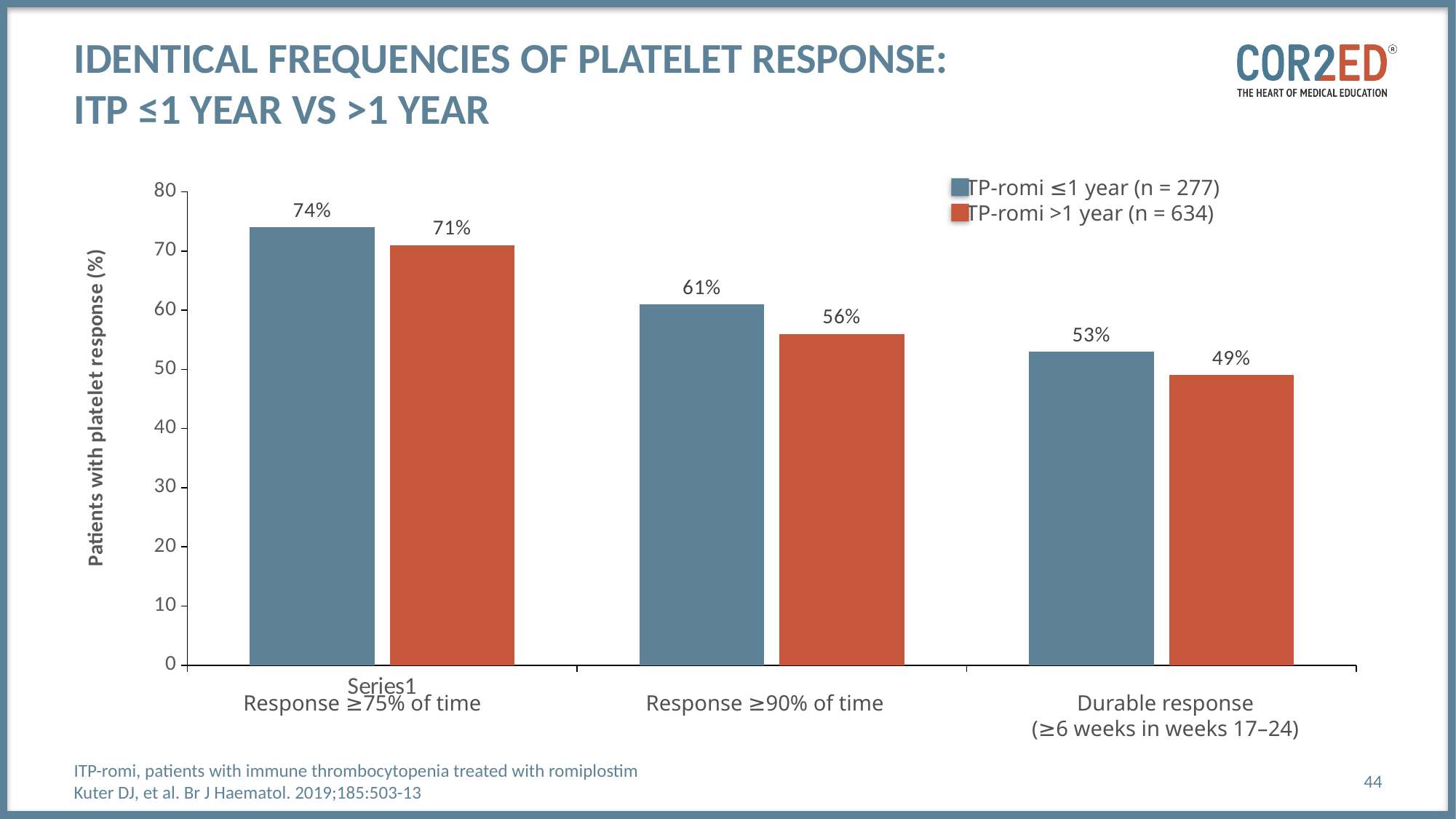
Do the ITP-romi >1 year values rise or fall from left to right across the categories? Fall What is the value for ITP-romi >1 year in the 'Response ≥90% of time' category? 56% Which category has the lowest value for ITP-romi >1 year? Durable response (≥6 weeks in weeks 17–24) What is the value for ITP-romi ≤1 year in the 'Response ≥75% of time' category? 74% What is the label of the y axis? Patients with platelet response (%) What is the difference between the ITP-romi ≤1 year and ITP-romi >1 year values in the 'Response ≥90% of time' category? 5% How many categories are shown on the x axis? 3 What is the value for ITP-romi >1 year in the 'Durable response (≥6 weeks in weeks 17–24)' category? 49% Which is larger in the 'Durable response' category: ITP-romi ≤1 year or ITP-romi >1 year? ITP-romi ≤1 year How many series does the legend list? 2 Which category has the highest value for ITP-romi ≤1 year? Response ≥75% of time What kind of chart is shown on the slide? Bar chart